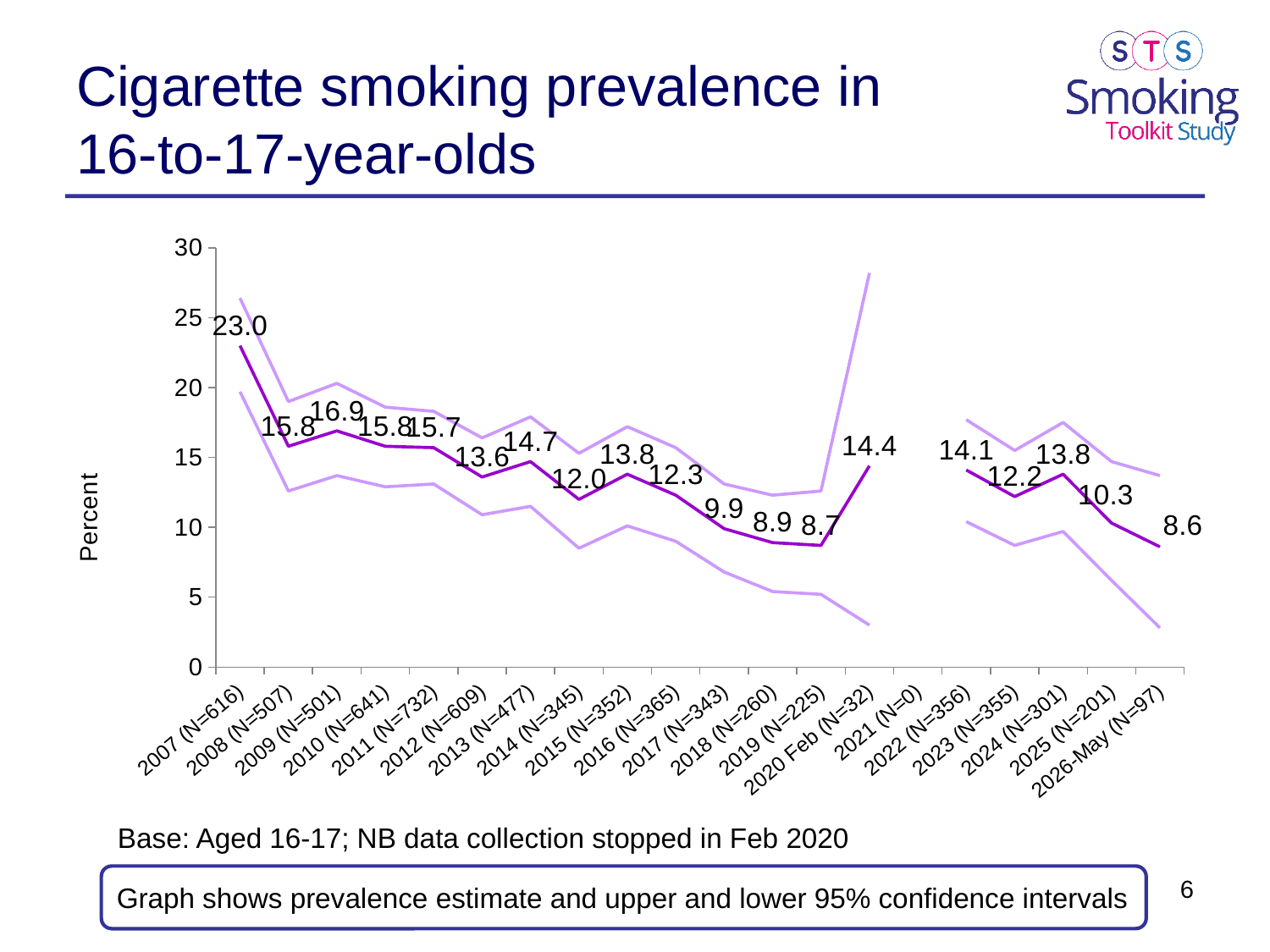
What is the prevalence estimate for 2020 Feb (N=32)? 14.4 Does the prevalence estimate generally rise or fall from 2007 to 2019? Fall How many year categories are shown on the x axis? 20 What is the prevalence estimate for 2026-May (N=97)? 8.6 Which has the higher prevalence estimate, 2022 (N=356) or 2024 (N=301)? 2022 (N=356) What kind of chart is shown on the slide? Line chart What is the difference between the prevalence estimates for 2007 (N=616) and 2008 (N=507)? 7.2 What is the difference between the prevalence estimates for 2024 (N=301) and 2025 (N=201)? 3.5 What is the label on the y axis? Percent What is the cigarette smoking prevalence for 2007 (N=616)? 23.0 Which year has the highest prevalence estimate? 2007 (N=616) What is the prevalence estimate for 2019 (N=225)? 8.7